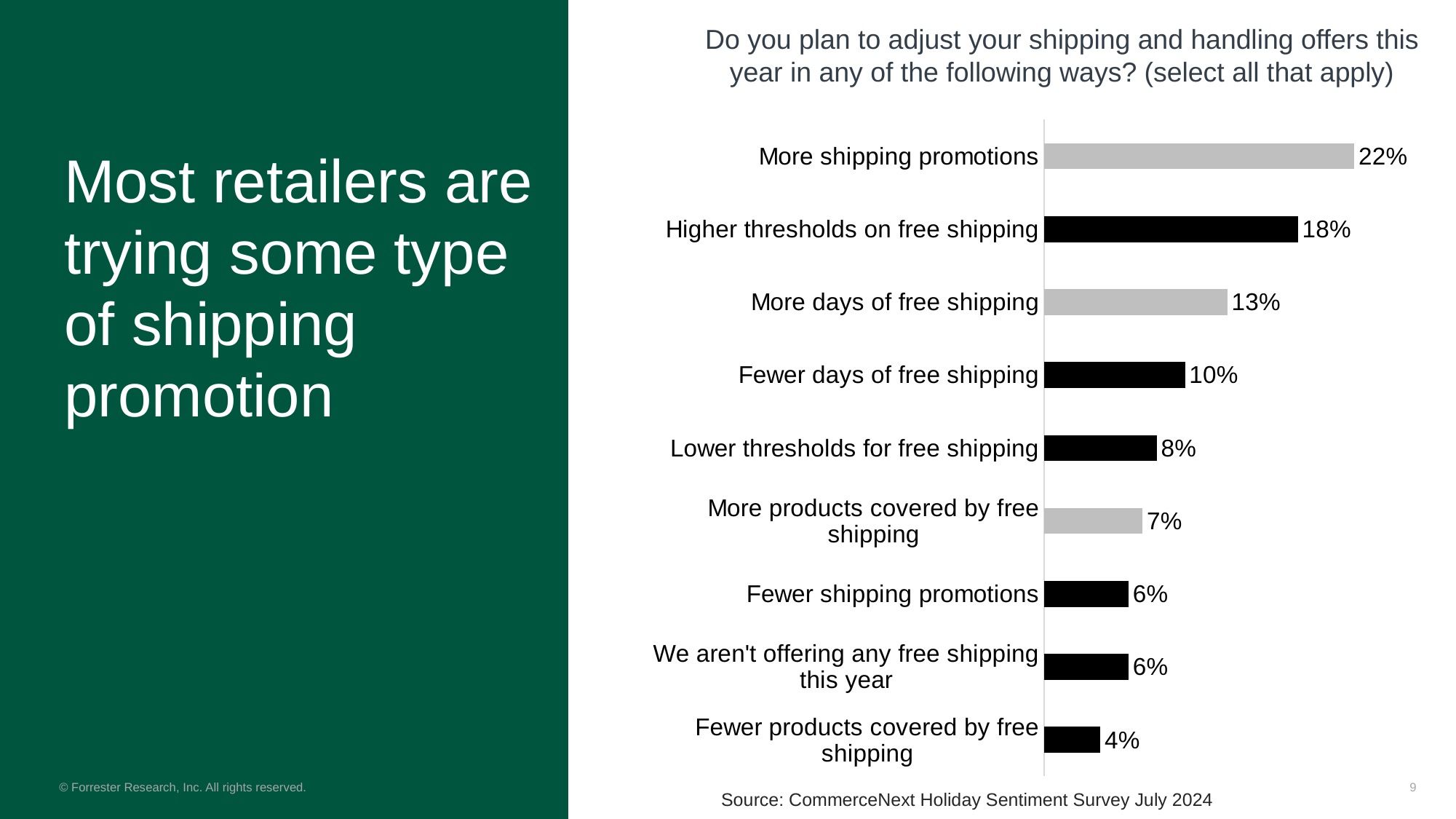
What is the difference between 'Lower thresholds for free shipping' and 'More products covered by free shipping'? 1% What kind of chart is shown on the slide? Bar chart What percentage of retailers plan more shipping promotions? 22% Which is larger: 'More days of free shipping' or 'Fewer days of free shipping'? More days of free shipping What is the value for 'Fewer products covered by free shipping'? 4% What is the value for 'Higher thresholds on free shipping'? 18% What percentage of retailers plan fewer days of free shipping? 10% What is the difference between 'More shipping promotions' and 'Higher thresholds on free shipping'? 4% How many categories are shown in the chart? 9 What is the source cited below the chart? CommerceNext Holiday Sentiment Survey July 2024 Which category has the lowest value? Fewer products covered by free shipping Which category has the highest value? More shipping promotions